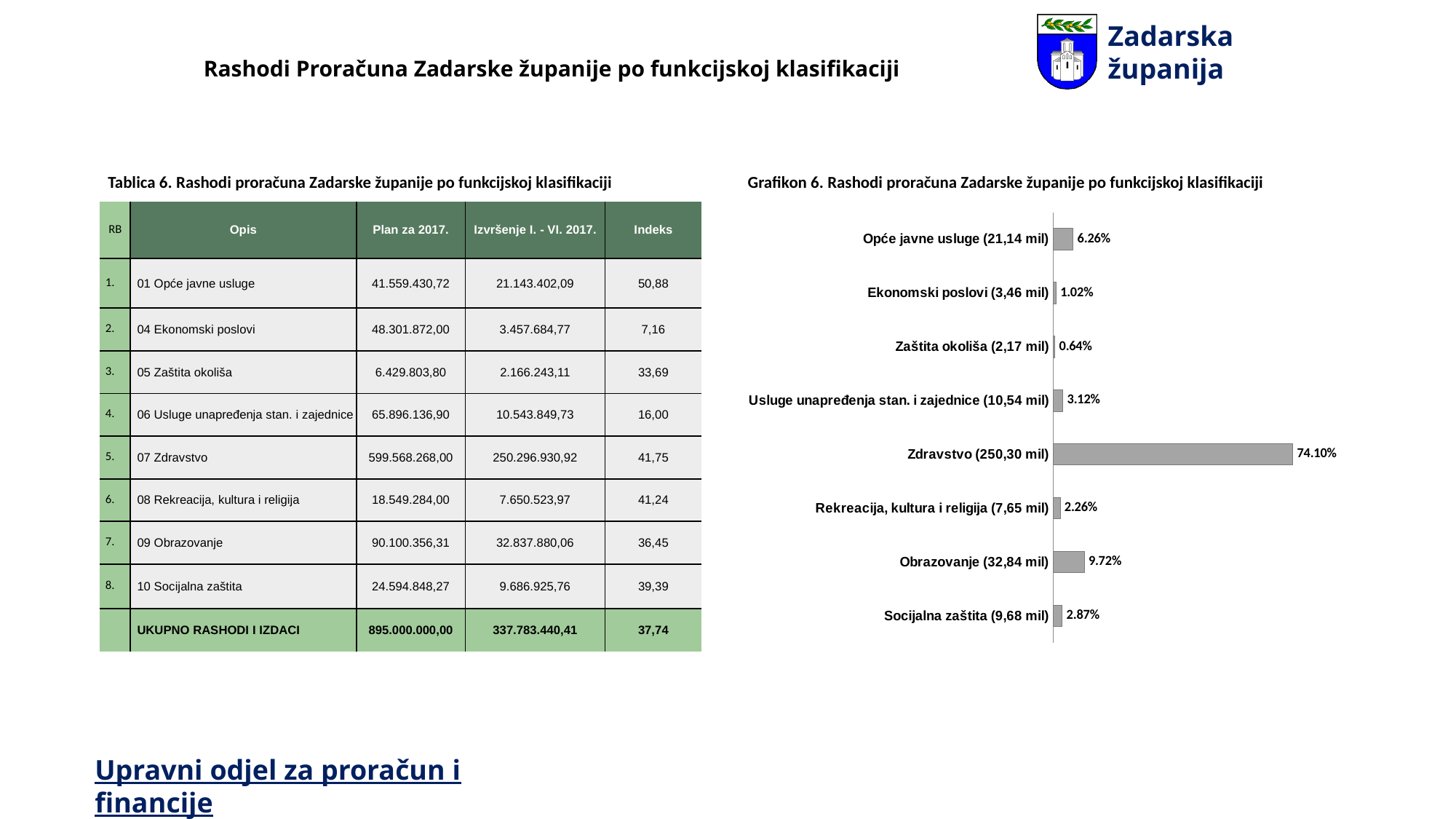
In Grafikon 6, what is the value shown for Ekonomski poslovi (3,46 mil)? 1.02% In Grafikon 6, what is the value shown for Obrazovanje (32,84 mil)? 9.72% In Grafikon 6, which category has the lowest value? Zaštita okoliša (2,17 mil) What type of chart is Grafikon 6? bar chart What is the title of the chart on the slide? Grafikon 6. Rashodi proračuna Zadarske županije po funkcijskoj klasifikaciji In Grafikon 6, which is larger: the value for Socijalna zaštita (9,68 mil) or Rekreacija, kultura i religija (7,65 mil)? Socijalna zaštita (9,68 mil) In Grafikon 6, what is the difference between the values for Zdravstvo (250,30 mil) and Obrazovanje (32,84 mil)? 64.38% In Grafikon 6, what is the value shown for Zdravstvo (250,30 mil)? 74.10% In Grafikon 6, what is the value shown for Socijalna zaštita (9,68 mil)? 2.87% In Grafikon 6, what is the difference between the values for Obrazovanje (32,84 mil) and Opće javne usluge (21,14 mil)? 3.46% How many categories are shown in Grafikon 6? 8 In Grafikon 6, which category has the highest value? Zdravstvo (250,30 mil)